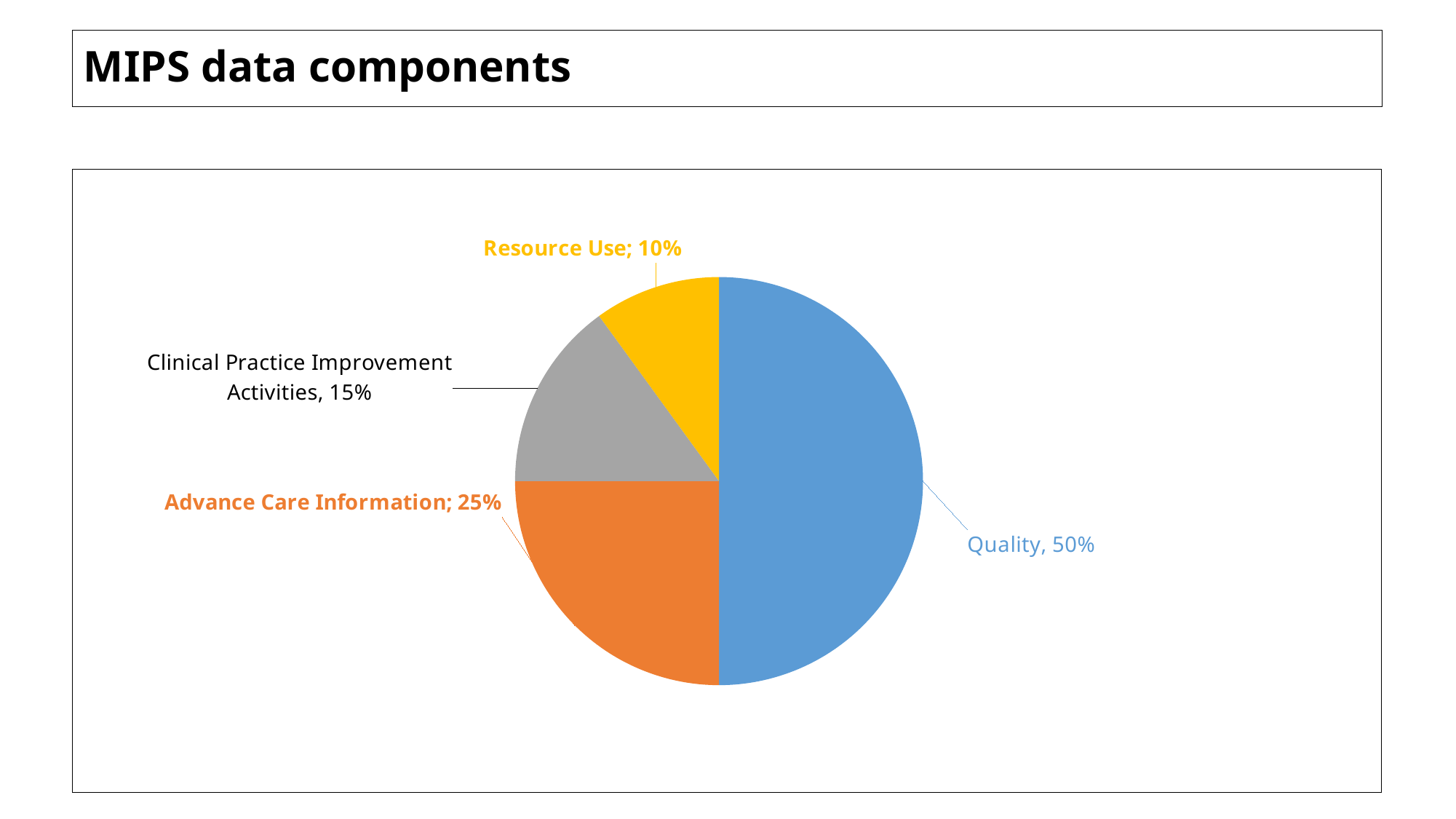
What is the value for Resource Use? 10% Which is larger, Advance Care Information or Clinical Practice Improvement Activities? Advance Care Information What kind of chart is shown on the slide? pie chart Which category has the smallest slice of the pie? Resource Use What is the difference between the Clinical Practice Improvement Activities and Resource Use shares? 5% What is the title of the slide? MIPS data components What is the value for Advance Care Information? 25% What is the value for Clinical Practice Improvement Activities? 15% Which category has the largest slice of the pie? Quality What share of the pie does Quality represent? 50% How many slices does the pie chart have? 4 What is the difference between the Quality and Advance Care Information shares? 25%